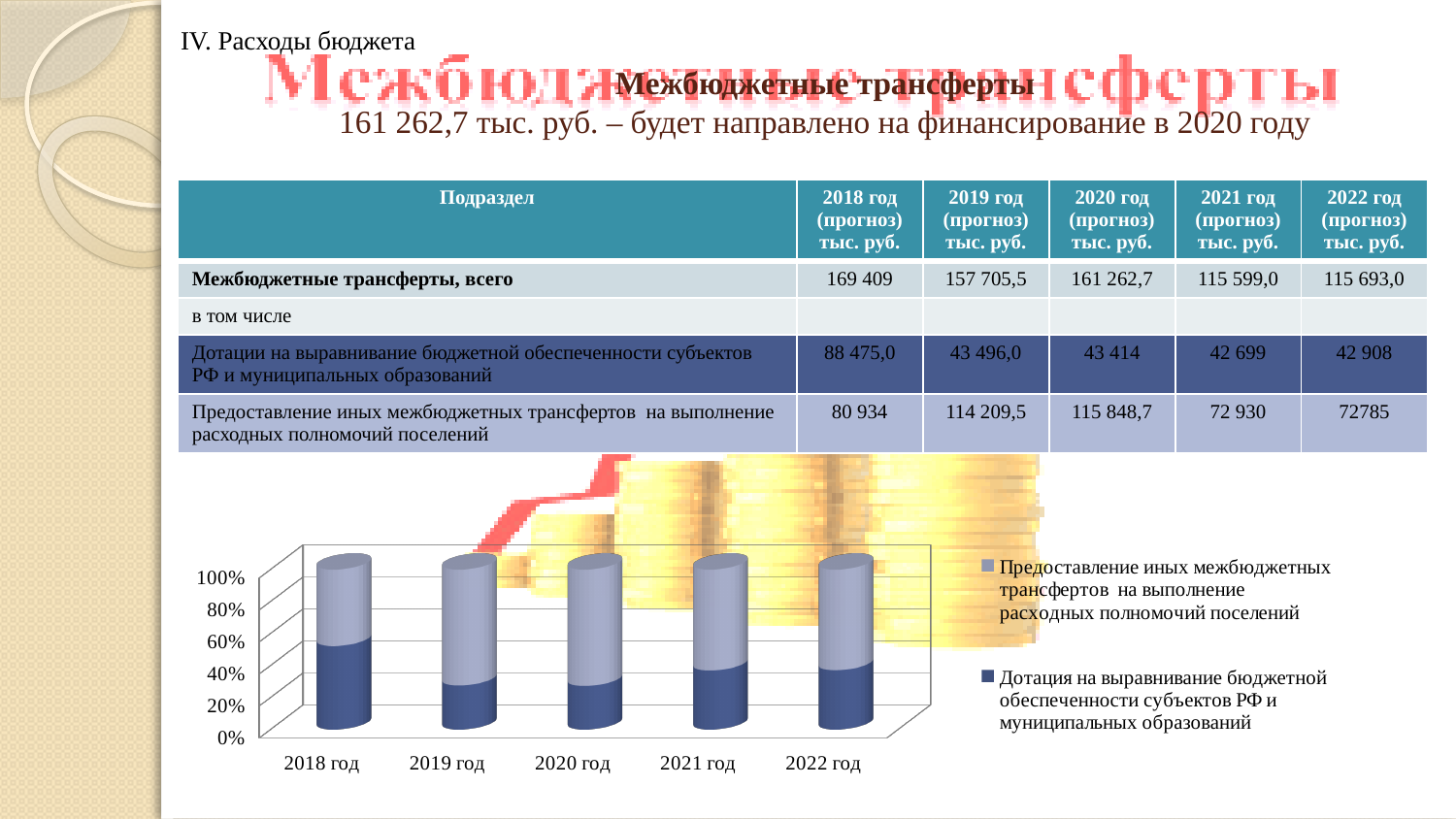
How many series does the chart legend list? 2 In the chart, which year has the larger share for «Предоставление иных межбюджетных трансфертов»: 2020 год or 2018 год? 2020 год What is the highest tick value shown on the vertical axis of the chart? 100% Which year has the largest share for «Дотация на выравнивание бюджетной обеспеченности субъектов РФ и муниципальных образований» in the chart? 2018 год In the chart, is the share for «Дотация на выравнивание бюджетной обеспеченности» in 2018 год greater or less than 40%? greater In the chart, is the share for «Дотация на выравнивание бюджетной обеспеченности» in 2019 год greater or less than 40%? less In the chart, is the share for «Предоставление иных межбюджетных трансфертов» in 2019 год greater or less than 60%? greater Which series is shown in dark blue in the chart? Дотация на выравнивание бюджетной обеспеченности субъектов РФ и муниципальных образований What kind of chart is shown on the slide? Stacked bar chart How many years (categories) are shown on the x axis of the chart? 5 In the chart, which year has the larger share for «Дотация на выравнивание бюджетной обеспеченности»: 2018 год or 2019 год? 2018 год